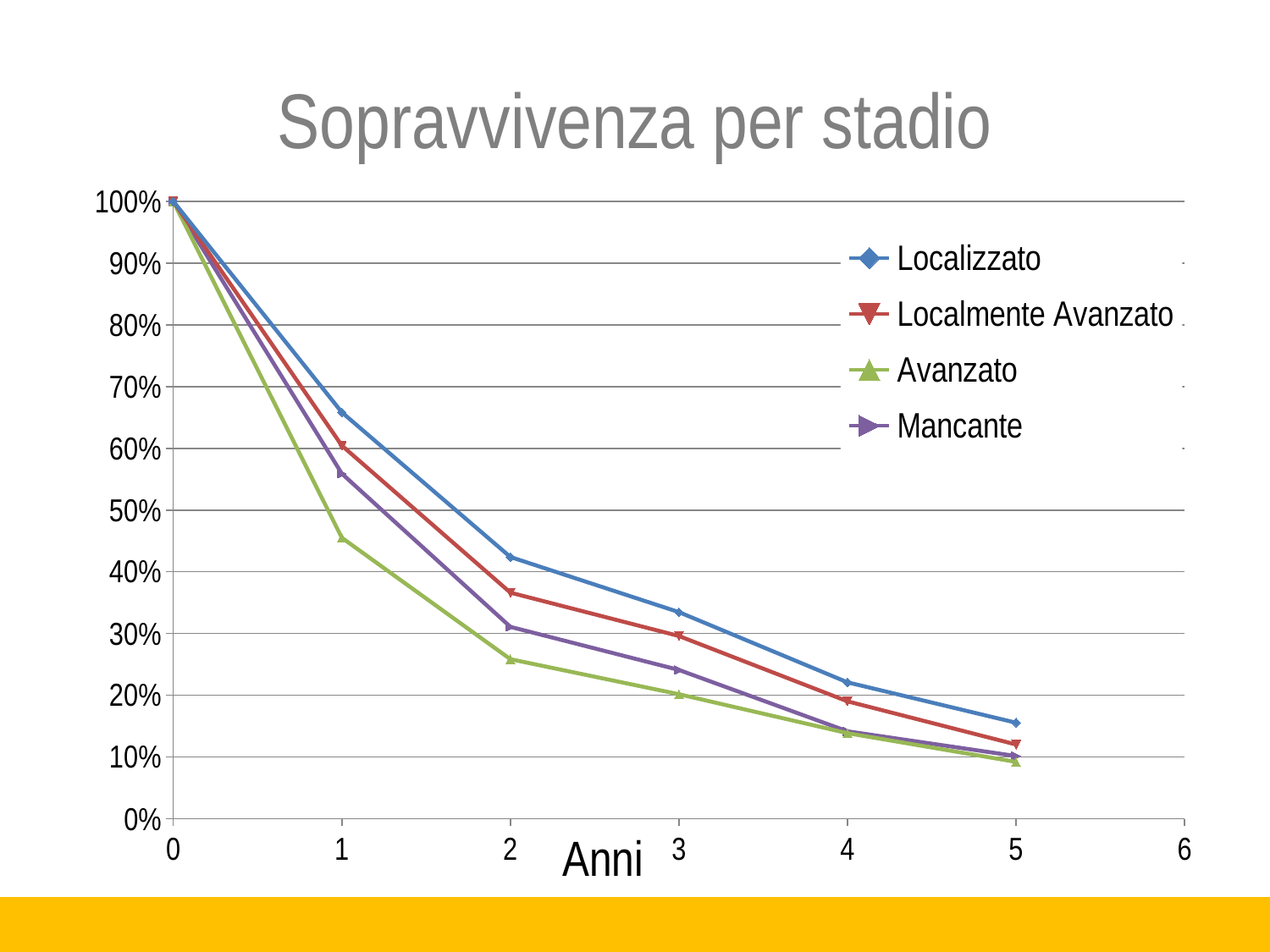
What kind of chart is shown on the slide? Line chart At year 2, which is larger: Localizzato or Avanzato? Localizzato Which series has the lowest value at year 1? Avanzato How many series does the legend list? 4 Is the value for Avanzato at year 1 greater or less than 50%? less Which series has the highest value at year 5? Localizzato What is the label of the x axis? Anni Is the value for Localizzato at year 1 greater or less than 60%? greater What is the value of the Localizzato series at year 0? 100% What is the title of the chart? Sopravvivenza per stadio Do the values of the Localizzato series rise or fall as the years increase? Fall Is the value for Localmente Avanzato at year 2 greater or less than 40%? less